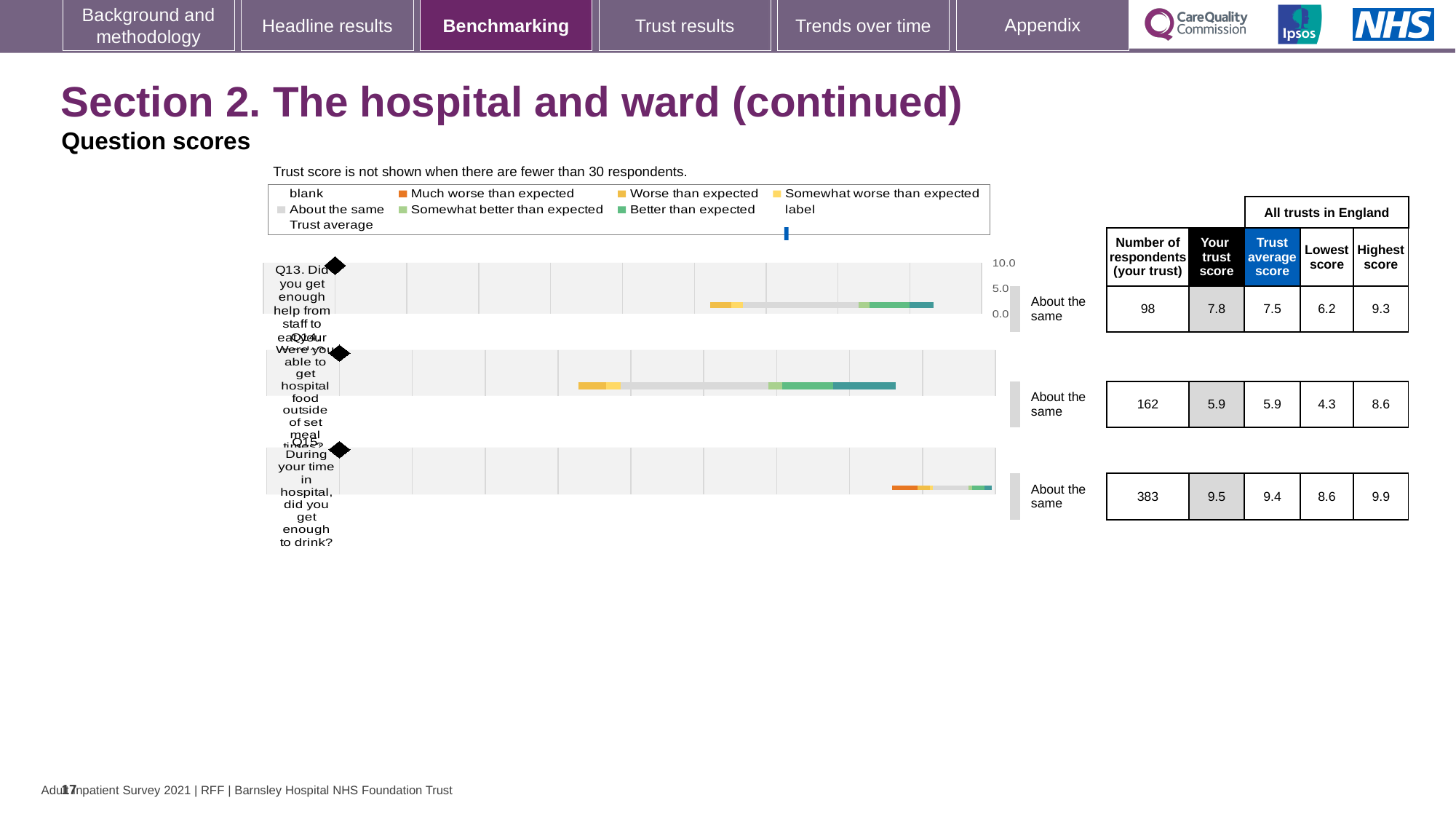
What benchmark category is shown for Q14 (Were you able to get hospital food outside of set meal times?)? About the same What is the difference between the highest and lowest scores in England for Q13? 3.1 What is the lowest score across all trusts in England for Q14? 4.3 What is the difference between the trust score and the trust average score for Q15? 0.1 According to the note above the chart, the trust score is not shown when there are fewer than how many respondents? 30 For Q13, which is larger: the trust score or the trust average score? Trust score What kind of chart is used to show the question scores? Bar chart How many questions are plotted on this slide? 3 Which of the three questions shown has the lowest trust score? Q14 Which of the three questions shown has the highest trust score? Q15 What is the trust score for Q13 (Did you get enough help from staff to eat your meals?)? 7.8 How many respondents answered Q15 (did you get enough to drink?) for this trust? 383